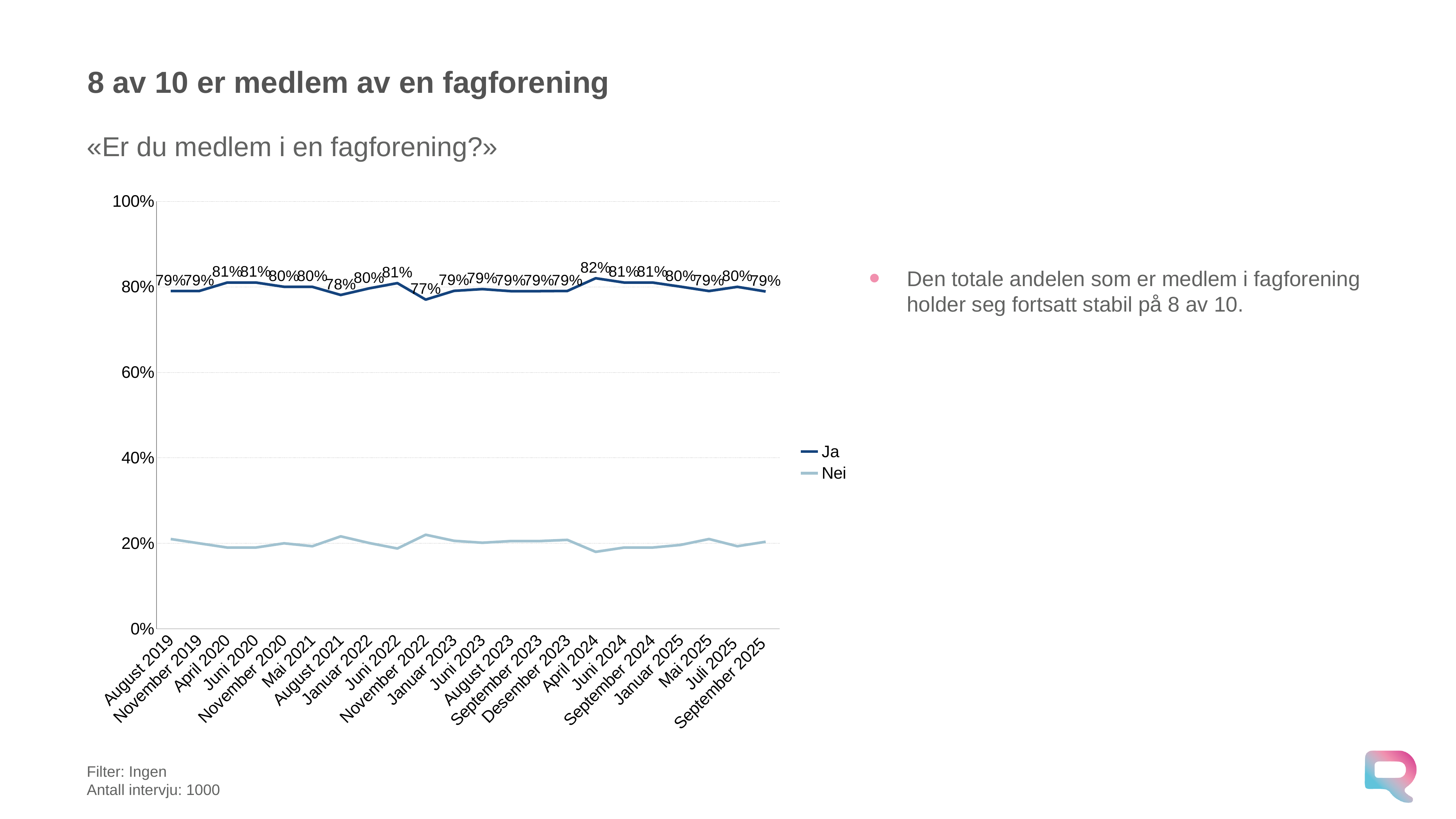
How many time periods are shown on the x axis? 22 What is the difference between the Ja value in April 2024 and the Ja value in November 2022? 5 percentage points Is the value for Nei in August 2019 greater or less than 40%? less What is the value of the Ja series for November 2022? 77% In which period does the Ja series reach its highest value? April 2024 What kind of chart is shown on the slide? Line chart Which series has the higher value in Juni 2023, Ja or Nei? Ja In which period does the Ja series reach its lowest value? November 2022 What is the value of the Ja series for April 2024? 82% How many series does the legend list? 2 What is the value of the Ja series for September 2025? 79% What is the value of the Ja series for August 2019? 79%